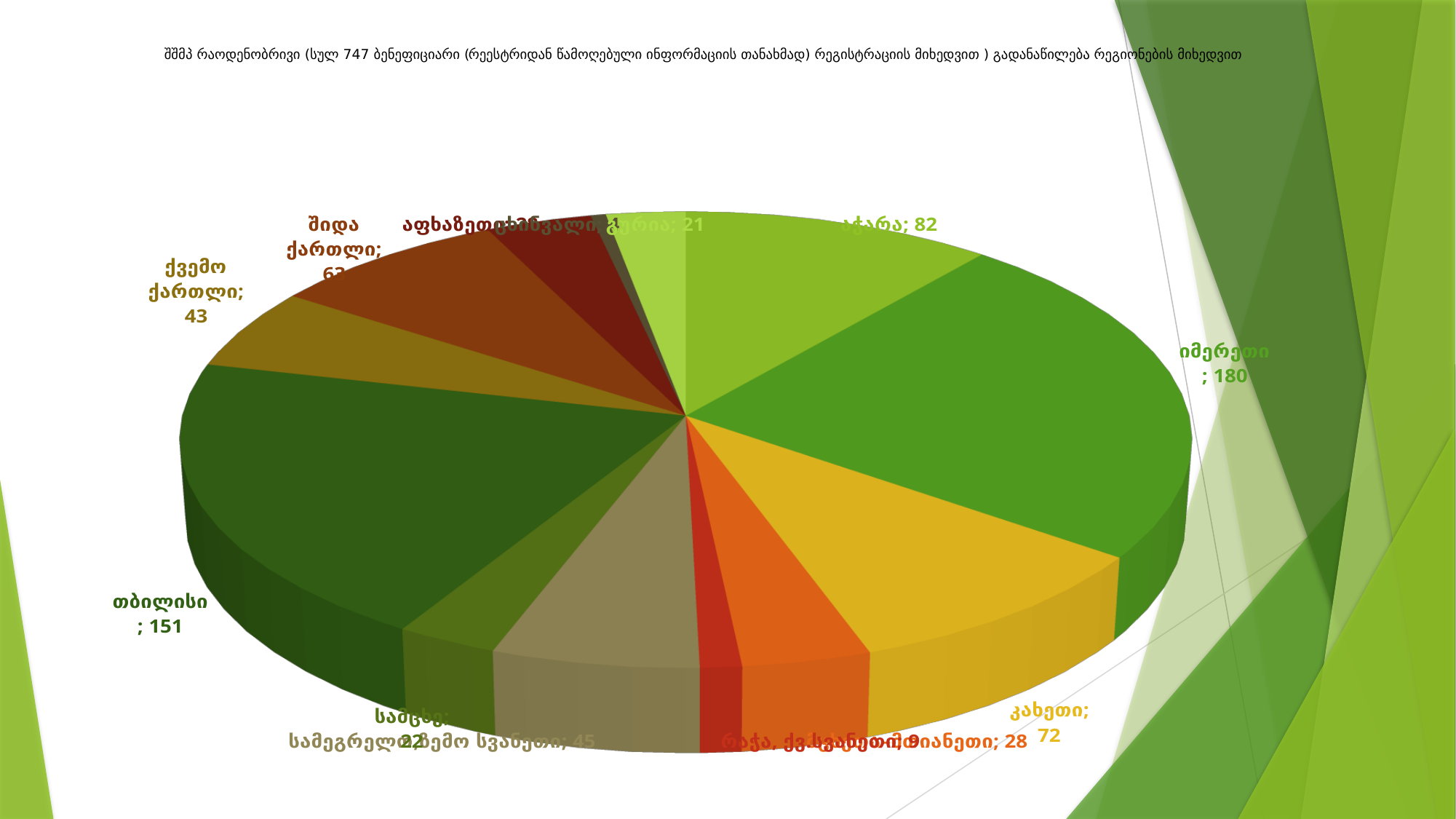
What is the difference between the values for აჭარა and კახეთი? 10 What is the value for თბილისი? 151 Which region has the largest slice of the pie? იმერეთი What is the value for ქვემო ქართლი? 43 According to the chart title, what is the total number of beneficiaries? 747 Which is larger, the value for თბილისი or the value for იმერეთი? იმერეთი What is the value for გურია? 21 What is the value for აჭარა? 82 What is the value for იმერეთი? 180 What type of chart is shown on the slide? pie chart What is the difference between the values for იმერეთი and თბილისი? 29 What is the value for კახეთი? 72